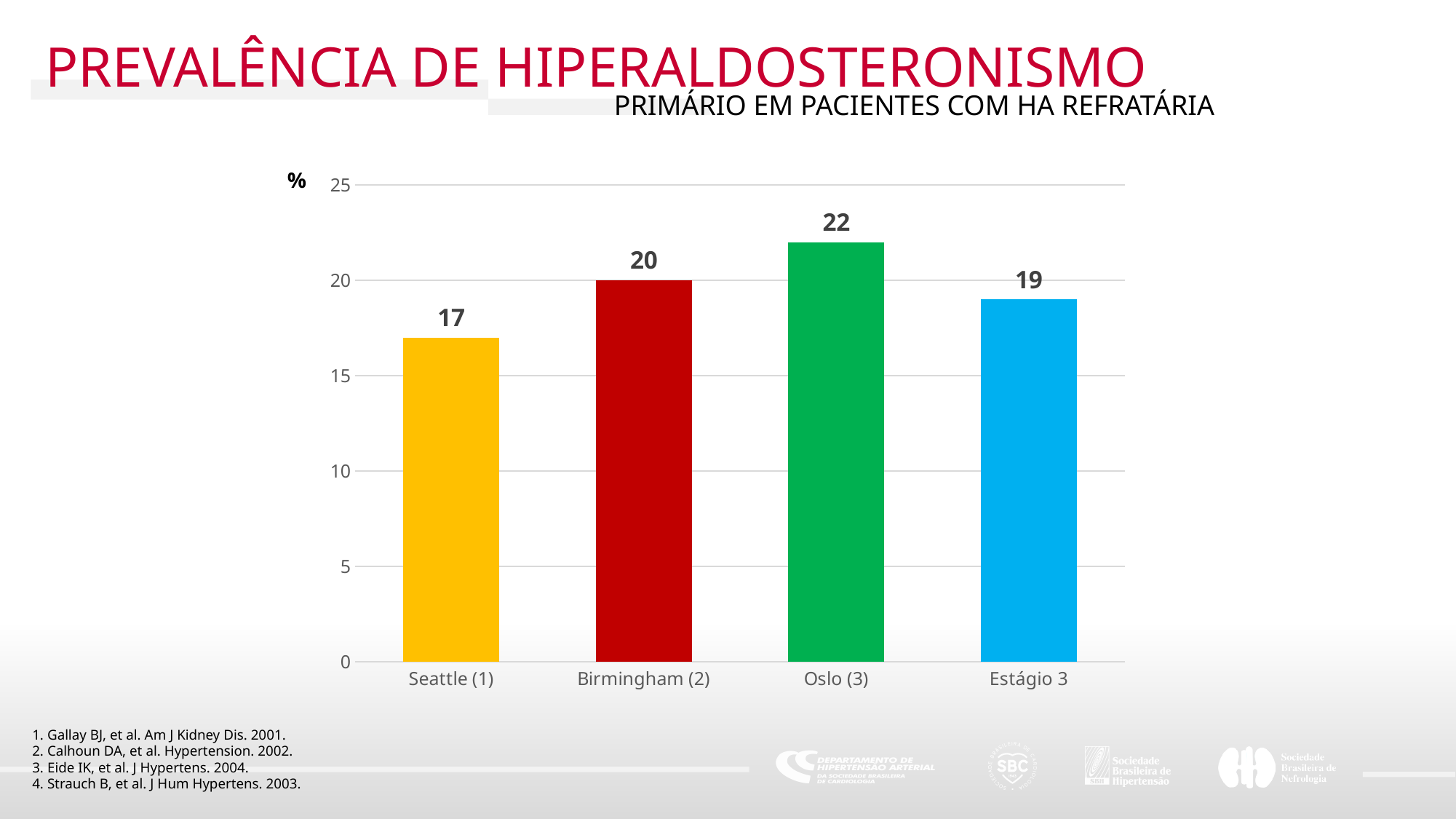
How many categories are shown on the x axis? 4 What is the value for Seattle (1)? 17 Which category has the lowest value? Seattle (1) What unit label is shown at the top of the vertical axis? % What is the value for Birmingham (2)? 20 What is the value for Estágio 3? 19 Which category has the highest value? Oslo (3) What is the value for Oslo (3)? 22 What kind of chart is shown on the slide? bar chart What is the difference between the values for Oslo (3) and Seattle (1)? 5 Is the value for Estágio 3 greater or less than 20? less Which is larger, the value for Birmingham (2) or the value for Estágio 3? Birmingham (2)